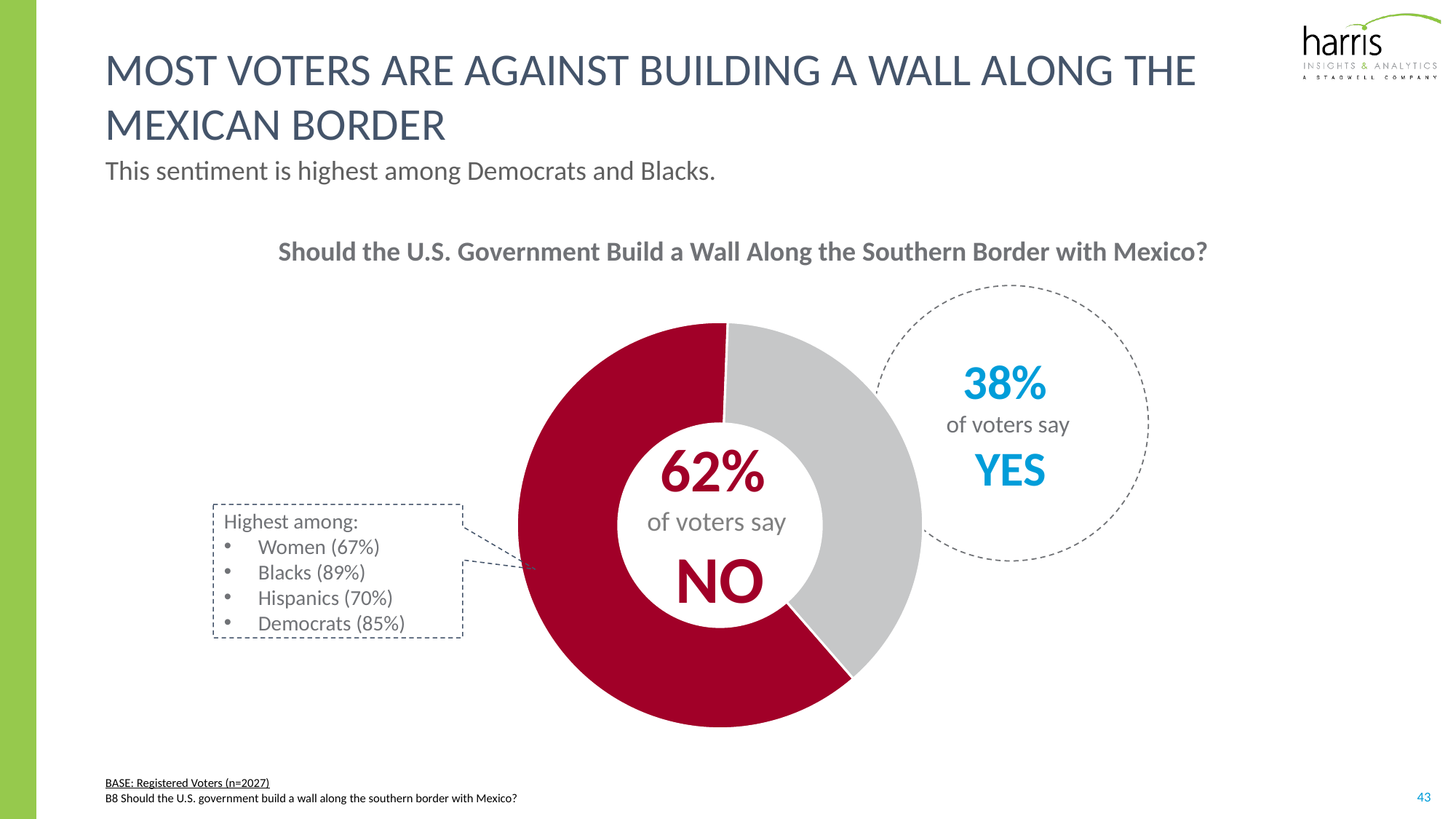
Which response has the larger share of the chart, YES or NO? NO What kind of chart is shown on the slide? Pie chart (donut) Which response has the smallest share of the chart? YES What is the title of the chart? Should the U.S. Government Build a Wall Along the Southern Border with Mexico? According to the callout, what percentage of Democrats say NO? 85% What colour is the NO segment of the chart? Red What percentage of voters say NO to building a wall along the southern border with Mexico? 62% What percentage of voters say YES to building a wall along the southern border with Mexico? 38% How many response categories does the chart show? 2 What is the difference in percentage points between voters who say NO and voters who say YES? 24 According to the callout, what percentage of Blacks say NO? 89% Among the groups listed in the callout, which has the highest share saying NO? Blacks